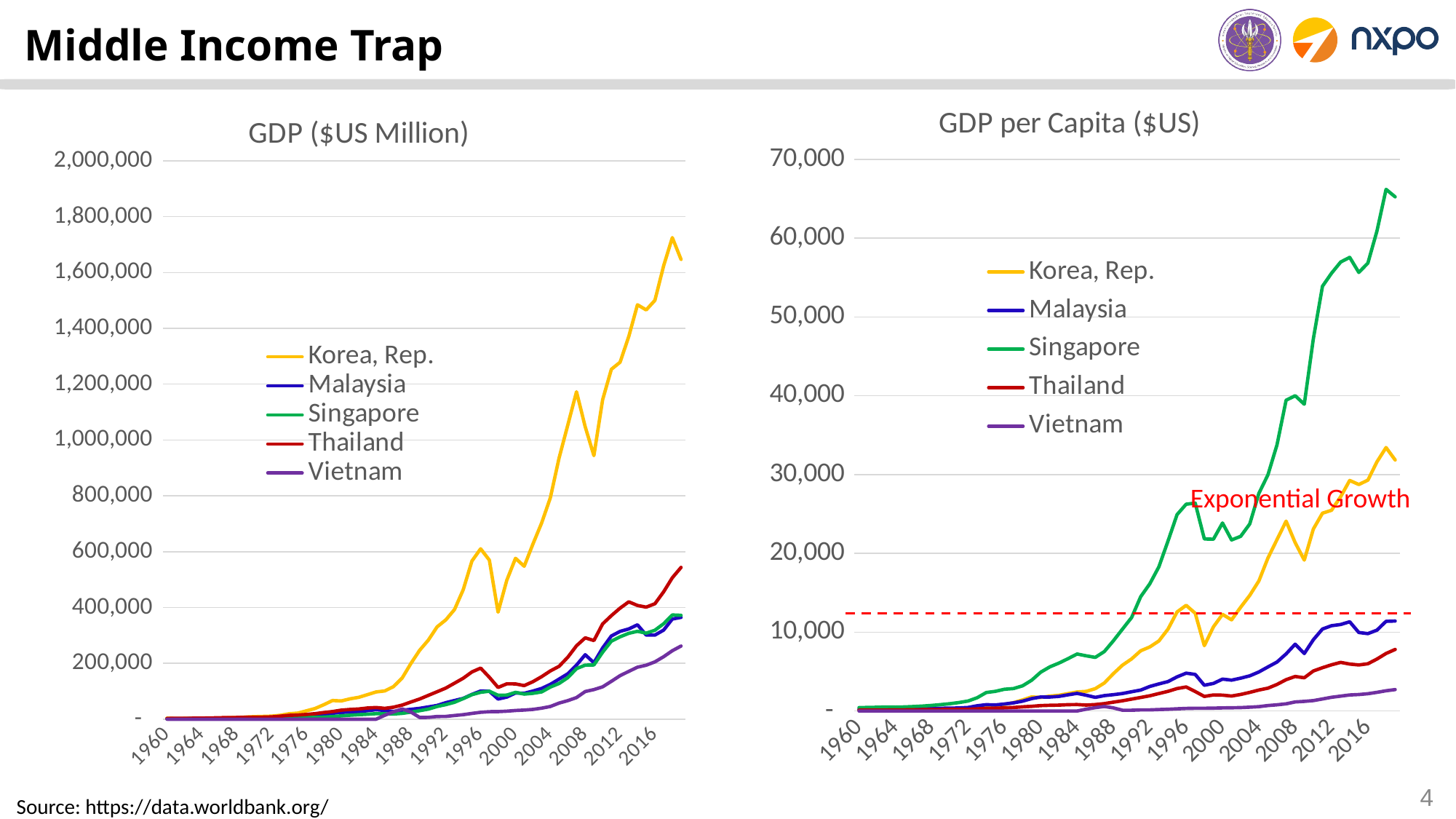
In the GDP per Capita ($US) chart, which is larger at the end of the series: Korea, Rep. or Malaysia? Korea, Rep. In the GDP ($US Million) chart, which country has the lowest GDP at the end of the series? Vietnam In the GDP ($US Million) chart, which country has the highest GDP at the end of the series (around 2018)? Korea, Rep. What red annotation text is written on the GDP per Capita ($US) chart? Exponential Growth In the GDP per Capita ($US) chart, which country has the highest GDP per capita at the end of the series? Singapore In the GDP ($US Million) chart, is the value for Thailand at the end of the series greater or less than 400,000? greater In the GDP per Capita ($US) chart, which country has the lowest GDP per capita at the end of the series? Vietnam What kind of chart is the GDP ($US Million) chart on the left? Line chart In the GDP per Capita ($US) chart, is the value for Thailand at the end of the series greater or less than 10,000? less In the GDP per Capita ($US) chart, is the peak value for Singapore greater or less than 60,000? greater How many series does the legend of the GDP per Capita ($US) chart list? 5